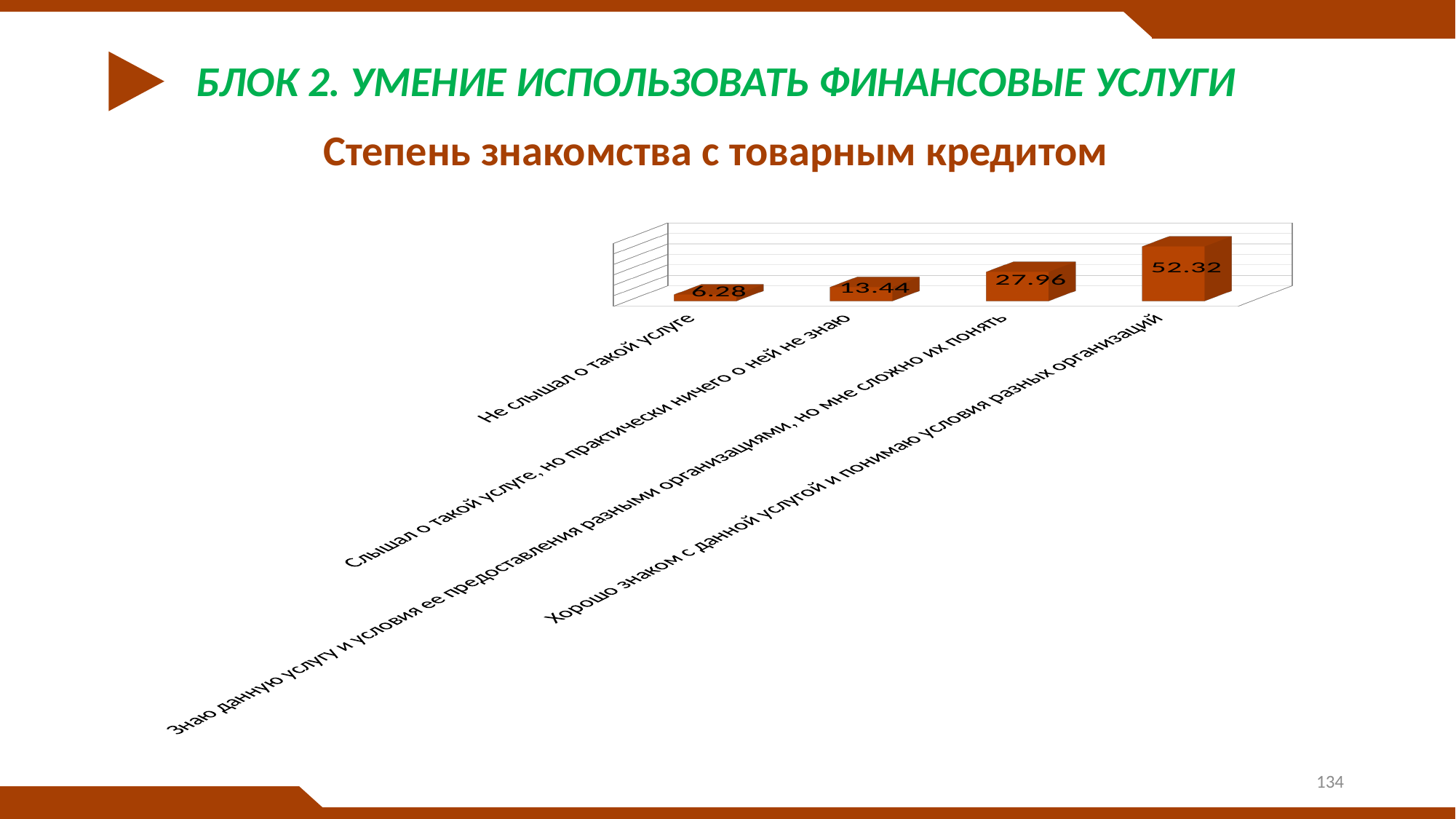
What is the difference between the values for "Хорошо знаком с данной услугой и понимаю условия разных организаций" and "Не слышал о такой услуге"? 46.04 What is the value for the category "Знаю данную услугу и условия ее предоставления разными организациями, но мне сложно их понять"? 27.96 What kind of chart is shown on the slide? Bar chart What is the value for the category "Не слышал о такой услуге"? 6.28 How many categories are shown in the chart? 4 Which category has the lowest value? Не слышал о такой услуге What is the difference between the values for "Знаю данную услугу и условия ее предоставления разными организациями, но мне сложно их понять" and "Слышал о такой услуге, но практически ничего о ней не знаю"? 14.52 Which category has the highest value? Хорошо знаком с данной услугой и понимаю условия разных организаций Which is larger: the value for "Слышал о такой услуге, но практически ничего о ней не знаю" or the value for "Не слышал о такой услуге"? Слышал о такой услуге, но практически ничего о ней не знаю What is the value for the category "Хорошо знаком с данной услугой и понимаю условия разных организаций"? 52.32 Do the values rise or fall from left to right along the x axis? Rise What is the value for the category "Слышал о такой услуге, но практически ничего о ней не знаю"? 13.44